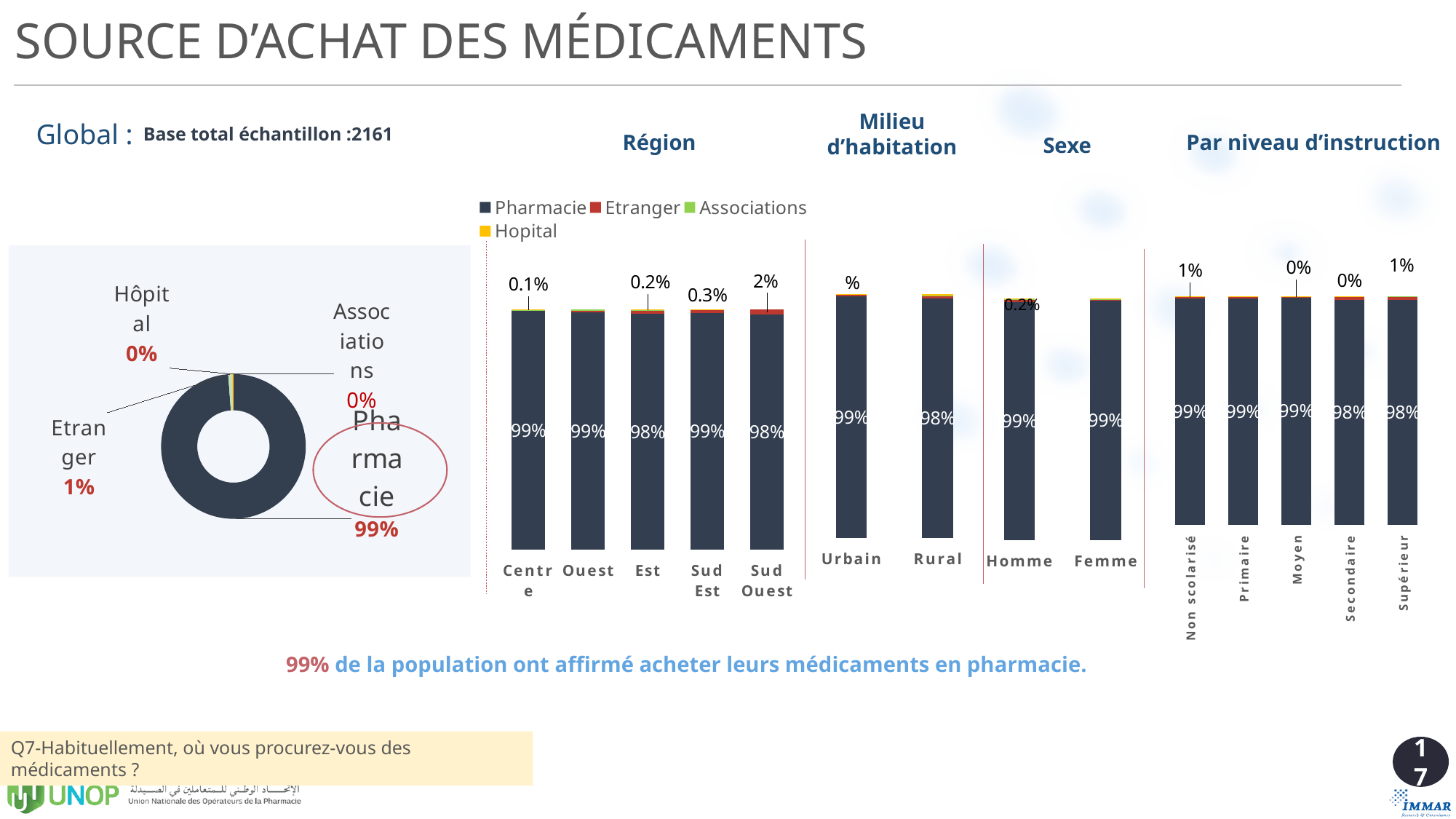
In the Global donut chart, what is the share for Hôpital? 0% In the Par niveau d'instruction bar chart, what is the Pharmacie value for Secondaire? 98% In the Global donut chart, what share of respondents buy their medicines at a Pharmacie? 99% In the Global donut chart, what is the share for Etranger? 1% In the Par niveau d'instruction bar chart, what is the difference between the Pharmacie values for Primaire and Supérieur? 1% How many series does the legend of the bar charts list? 4 In the Région bar chart, what is the Pharmacie value for Est? 98% How many regions are shown in the Région bar chart? 5 In the Région bar chart, what is the Pharmacie value for Sud Est? 99% What kind of chart is the Global chart on the left of the slide? Donut (pie) chart In the Région bar chart, what is the small value labelled above the Sud Ouest bar? 2% In the Milieu d'habitation bar chart, what is the Pharmacie value for Rural? 98%